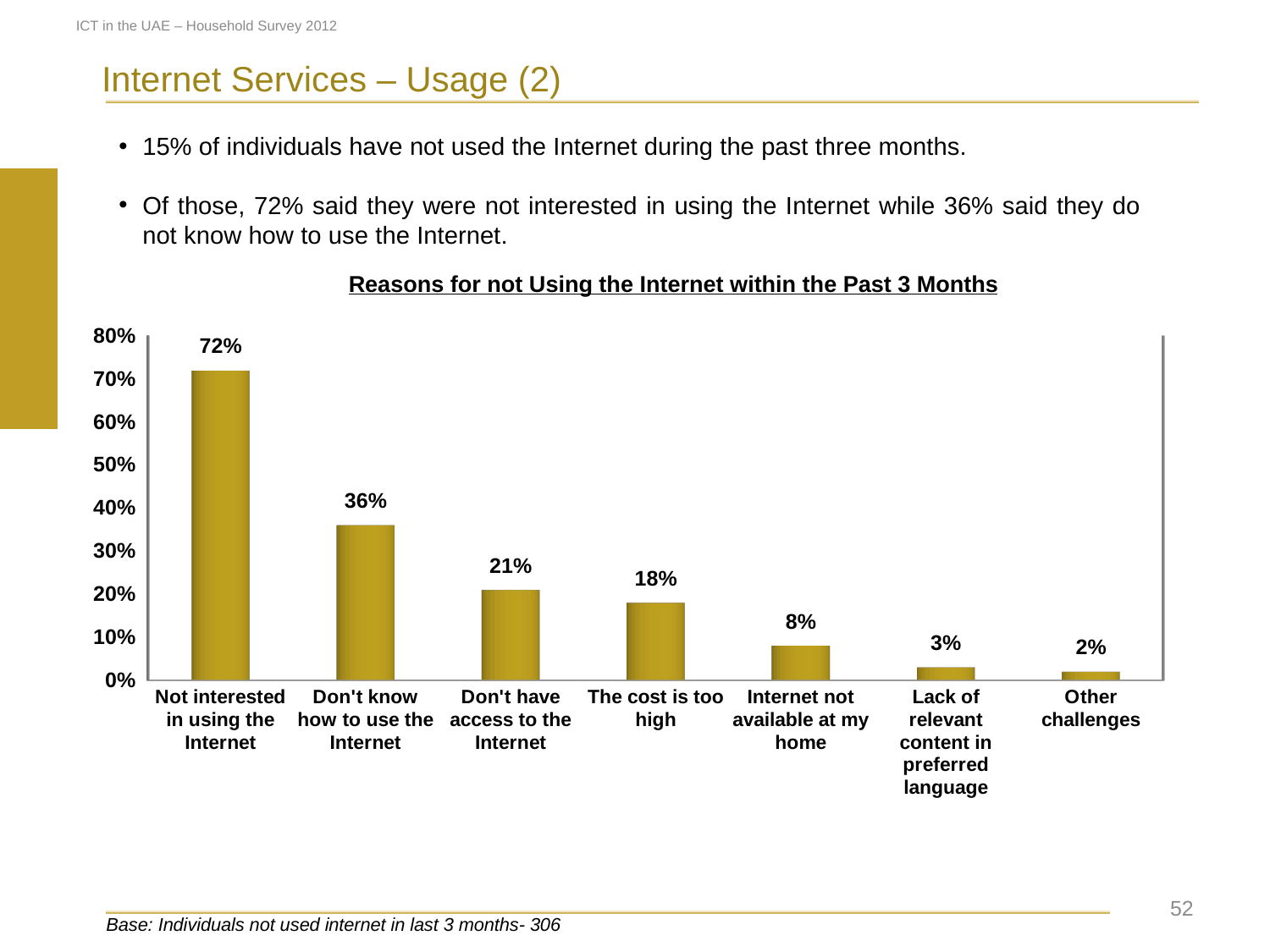
Which reason has the highest percentage? Not interested in using the Internet What is the value for 'The cost is too high'? 18% Which reason has the lowest percentage? Other challenges What type of chart is shown on the slide? Bar chart What percentage of respondents said they were not interested in using the Internet? 72% Is the value for 'Don't know how to use the Internet' greater or less than 30%? greater How many reasons are shown in the chart? 7 What is the difference between 'Don't know how to use the Internet' and 'Don't have access to the Internet'? 15% Do the values rise or fall from left to right across the categories? Fall What percentage cited 'Lack of relevant content in preferred language'? 3% What is the title of the chart? Reasons for not Using the Internet within the Past 3 Months Which is larger: 'Internet not available at my home' or 'The cost is too high'? The cost is too high